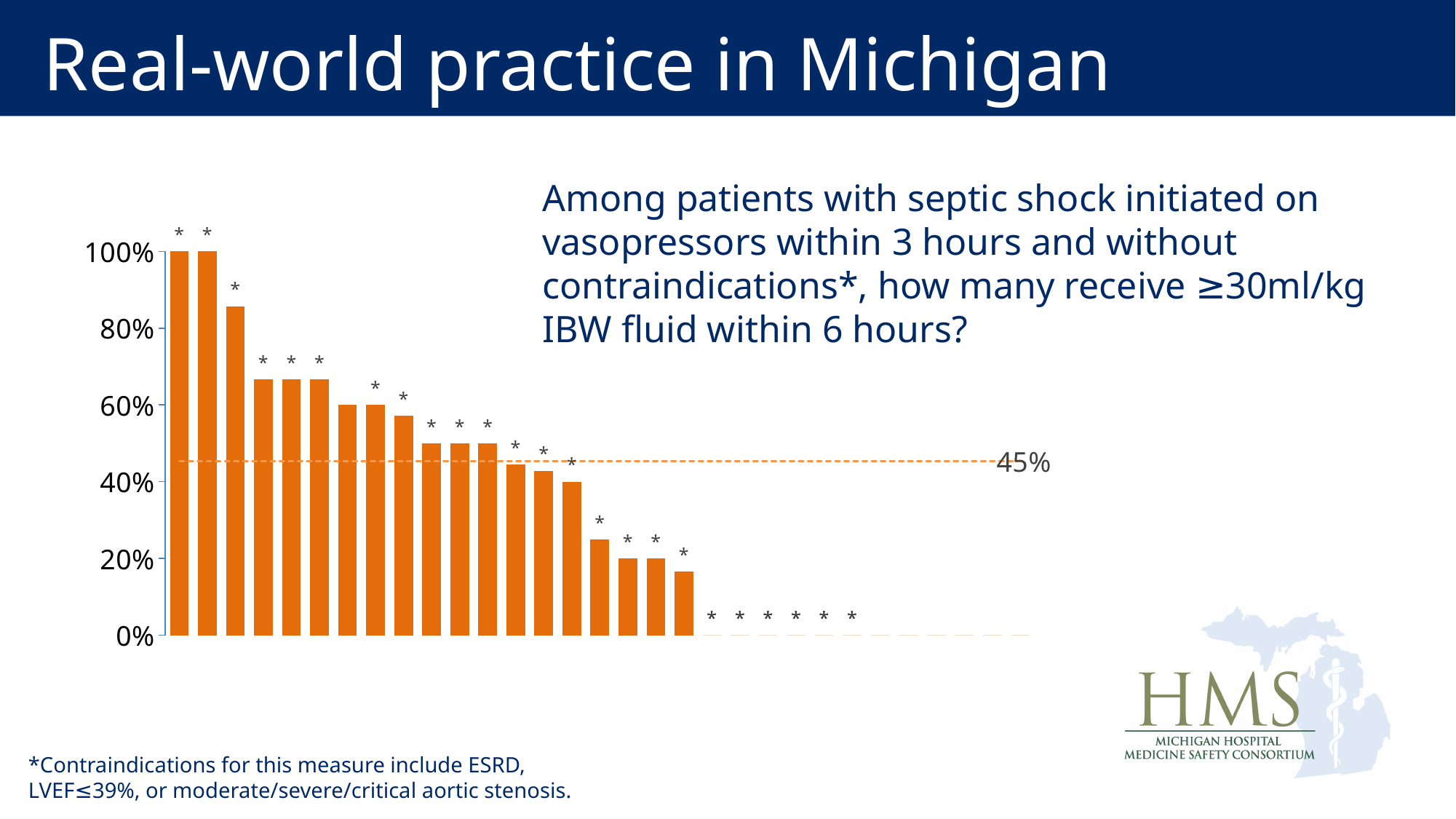
How many asterisks sit on the 0% line to the right of the last visible bar? 6 What value is labelled on the dashed horizontal reference line across the chart? 45% Which is larger, the leftmost bar or the third bar from the left? the leftmost bar Is the value of the leftmost bar greater or less than 80%? greater What colour are the bars in the chart? orange What kind of chart is shown on the slide? bar chart Do the bar values rise or fall from left to right across the chart? fall Is the value of the rightmost visible (non-zero) bar greater or less than 20%? less How many bars reach the 100% line? 2 How many bars with a visible (non-zero) height are plotted in the chart? 19 What is the highest value reached by any bar in the chart? 100% Is the value of the third bar from the left greater or less than 80%? greater